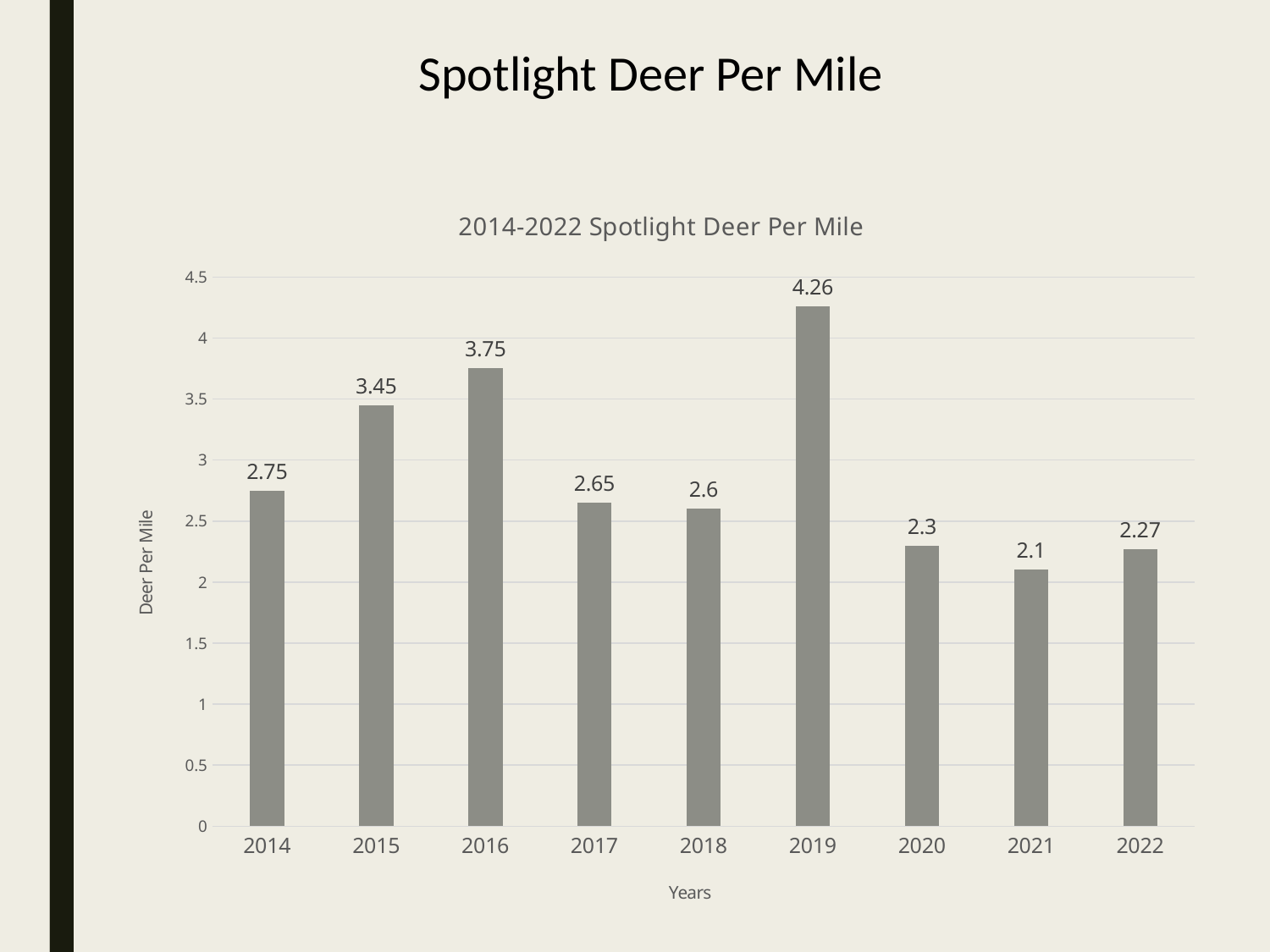
Which year has the lowest deer per mile? 2021 What is the value for 2019? 4.26 What is the difference between the values for 2019 and 2021? 2.16 Which is larger, the value for 2017 or the value for 2018? 2017 Which year has the highest deer per mile? 2019 What is the difference between the values for 2016 and 2015? 0.3 How many years are shown on the x axis? 9 What kind of chart is shown? bar chart Is the value for 2016 greater or less than 3.5? greater What is the title of the chart? 2014-2022 Spotlight Deer Per Mile What is the value for 2014? 2.75 What is the value for 2022? 2.27